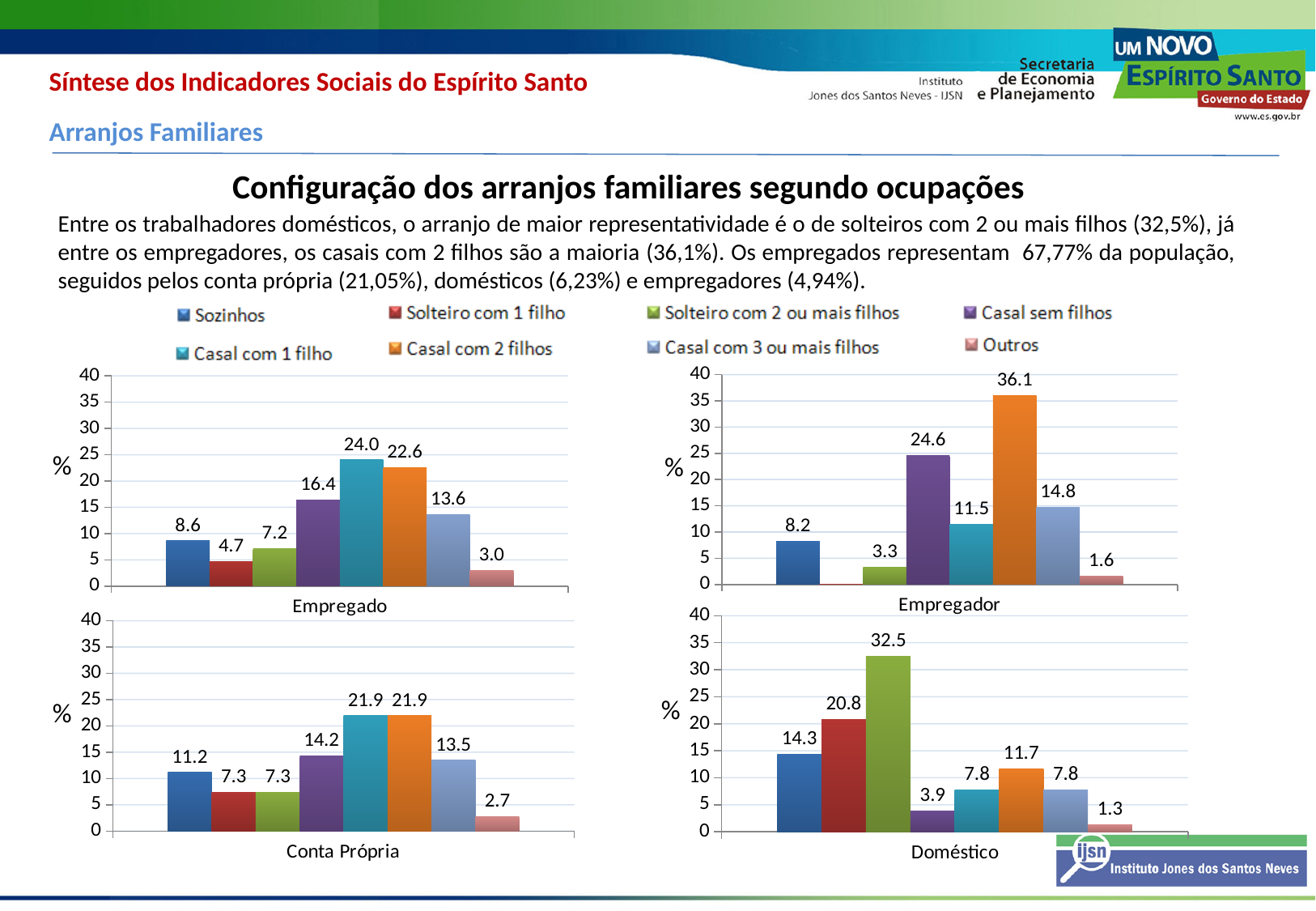
In the Empregado chart, what is the value for Casal com 1 filho? 24.0 How many series does the legend list? 8 In the Empregador chart, which family arrangement has the highest value? Casal com 2 filhos In the Empregador chart, what is the value for Outros? 1.6 What kind of chart is the Conta Própria chart? Bar chart In the Doméstico chart, what is the difference between the values for Solteiro com 2 ou mais filhos and Solteiro com 1 filho? 11.7 In the Empregado chart, which is larger: the value for Sozinhos or the value for Solteiro com 2 ou mais filhos? Sozinhos In the Doméstico chart, what is the value for Solteiro com 2 ou mais filhos? 32.5 In the Conta Própria chart, what is the value for Casal com 3 ou mais filhos? 13.5 In the Doméstico chart, which family arrangement has the lowest value? Outros In the Conta Própria chart, what is the difference between the values for Casal com 1 filho and Casal sem filhos? 7.7 In the Empregador chart, what is the value for Casal sem filhos? 24.6